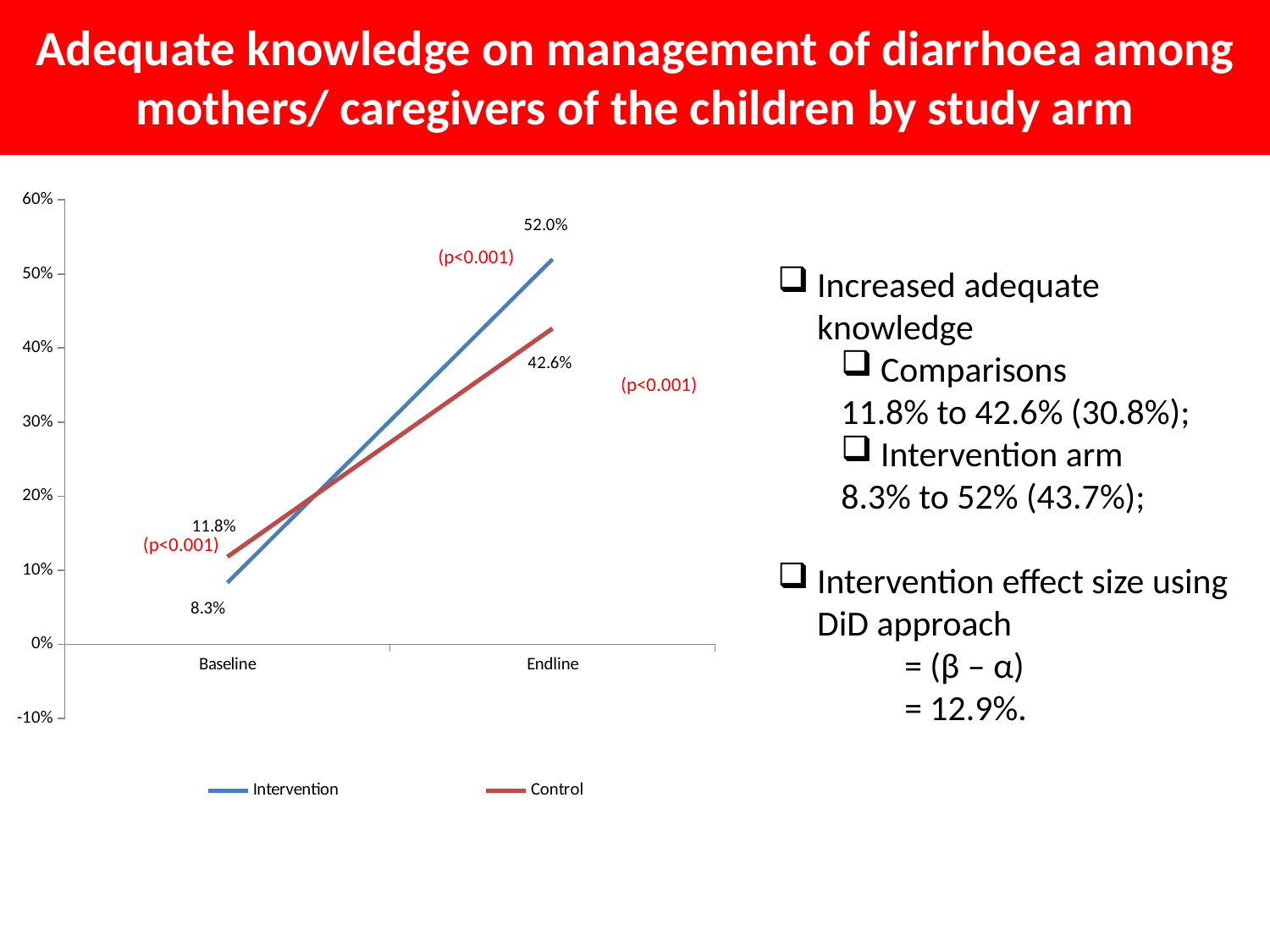
By how much did the Intervention value increase from Baseline to Endline? 43.7% What is the difference between the Intervention and Control values at Endline? 9.4% Which series has the higher value at Baseline? Control Does the Control series rise or fall from Baseline to Endline? Rise What kind of chart is shown? Line chart What is the Control value at Baseline? 11.8% What colour is the Intervention line? Blue What is the Intervention value at Endline? 52.0% Which series has the higher value at Endline? Intervention What is the Intervention value at Baseline? 8.3% How many series does the legend list? 2 What is the Control value at Endline? 42.6%